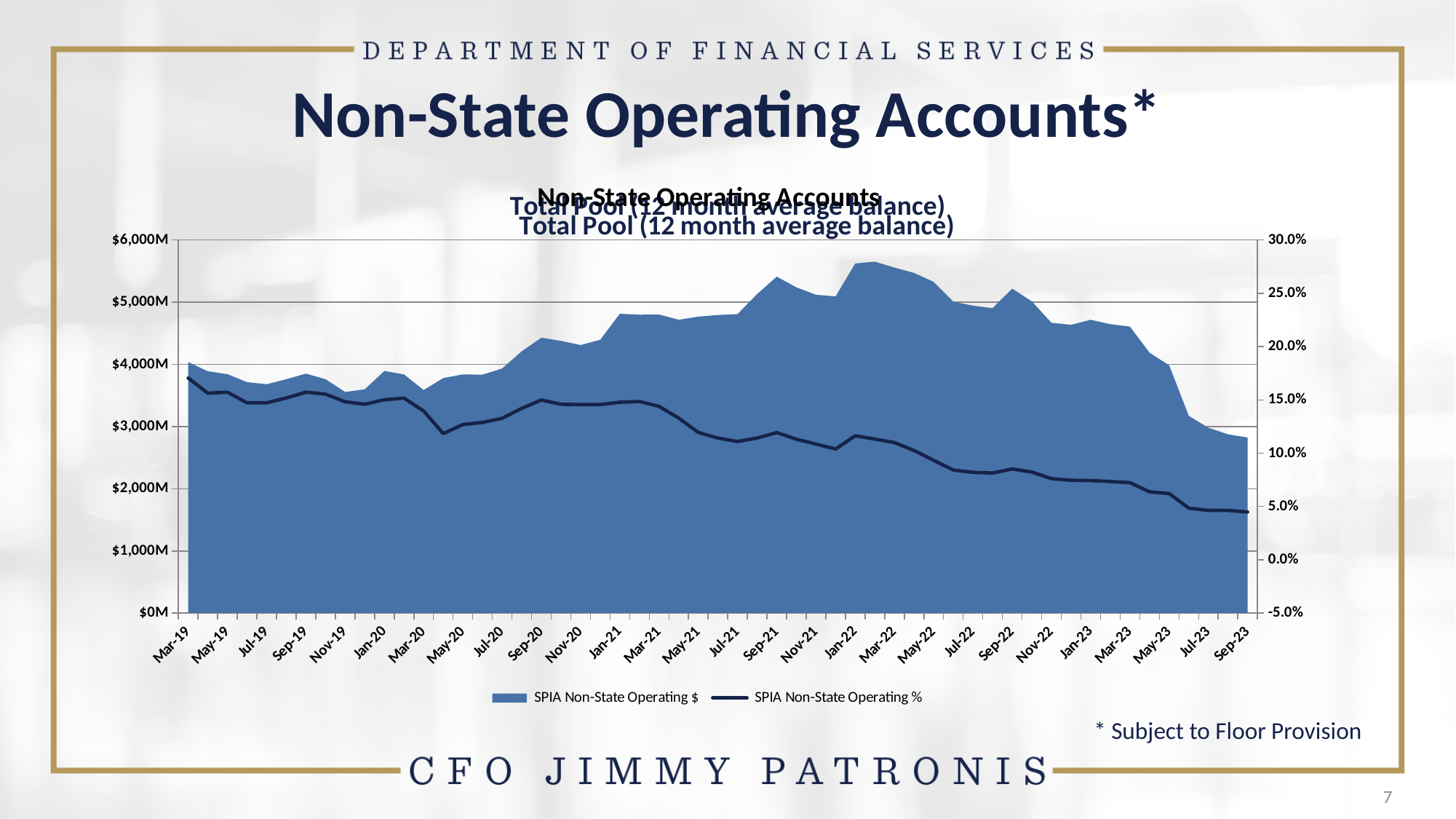
Is the SPIA Non-State Operating $ value for Sep-23 greater or less than $3,000M? less What are the two series named in the chart legend? SPIA Non-State Operating $ and SPIA Non-State Operating % Is the SPIA Non-State Operating % value for Mar-19 greater or less than 15.0%? greater How many series does the chart legend list? 2 What kind of chart is shown on the slide? A combined area and line chart Does the SPIA Non-State Operating % line generally rise or fall from Mar-19 to Sep-23? fall Which is larger, the SPIA Non-State Operating % value for Jan-20 or for Jan-23? Jan-20 Which is larger, the SPIA Non-State Operating $ value for Mar-22 or for Mar-20? Mar-22 Is the SPIA Non-State Operating % value for Sep-23 greater or less than 10.0%? less Which is larger, the SPIA Non-State Operating $ value for Mar-19 or for Sep-23? Mar-19 What is the first month shown on the x axis of the chart? Mar-19